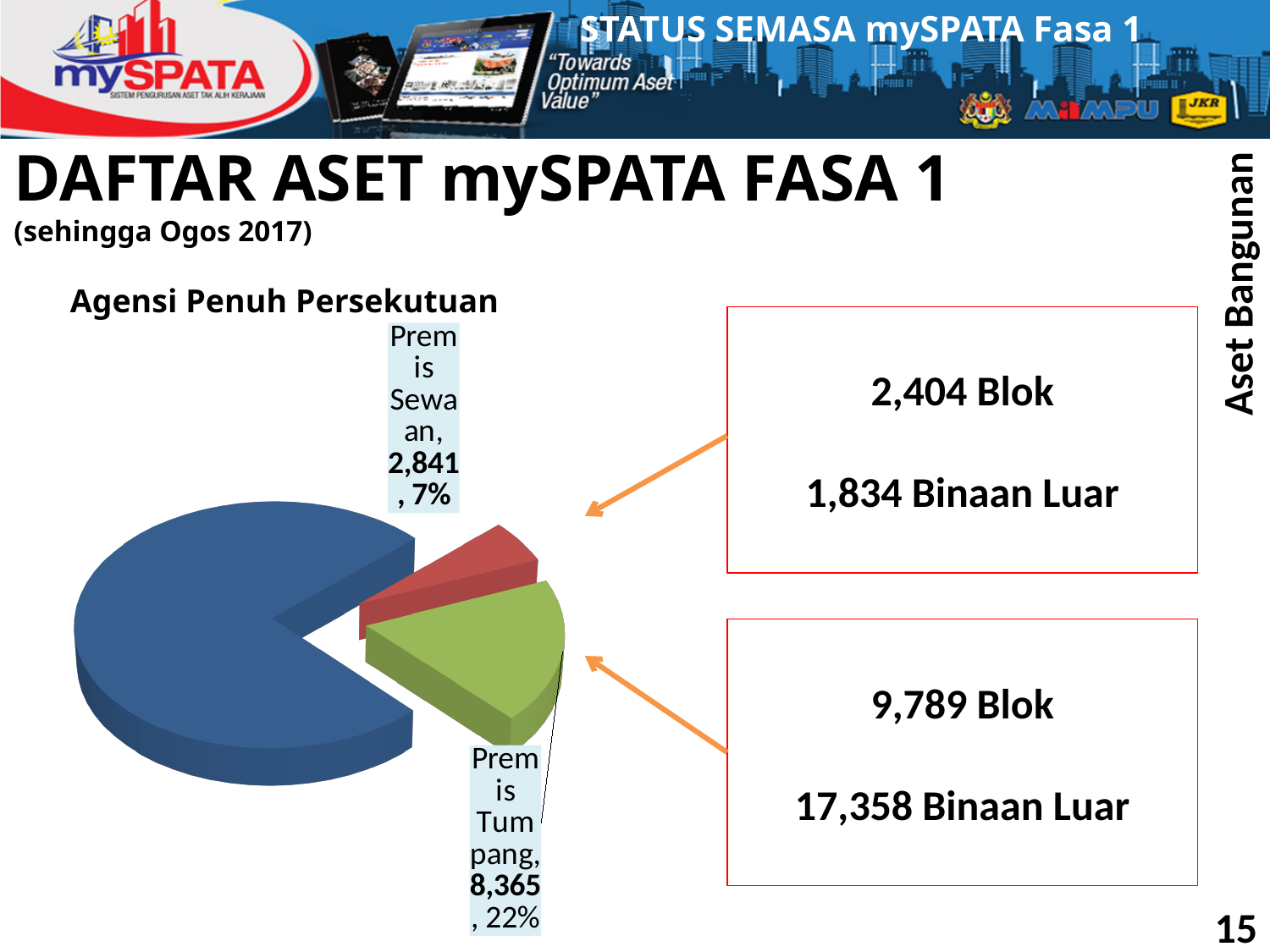
What colour is the Premis Tumpang slice in the pie chart? Green Which slice of the pie chart is the smallest? Premis Sewaan What is the value shown for Premis Sewaan in the pie chart? 2,841 Which is larger in the pie chart, Premis Sewaan or Premis Tumpang? Premis Tumpang What share of the pie does Premis Tumpang represent? 22% What share of the pie does Premis Sewaan represent? 7% What is the value shown for Premis Tumpang in the pie chart? 8,365 What is the title of the pie chart? Agensi Penuh Persekutuan What is the difference between the values for Premis Tumpang and Premis Sewaan? 5,524 By how many percentage points does the share of Premis Tumpang exceed that of Premis Sewaan? 15% What kind of chart is shown on the slide? Pie chart How many slices does the pie chart have? 3